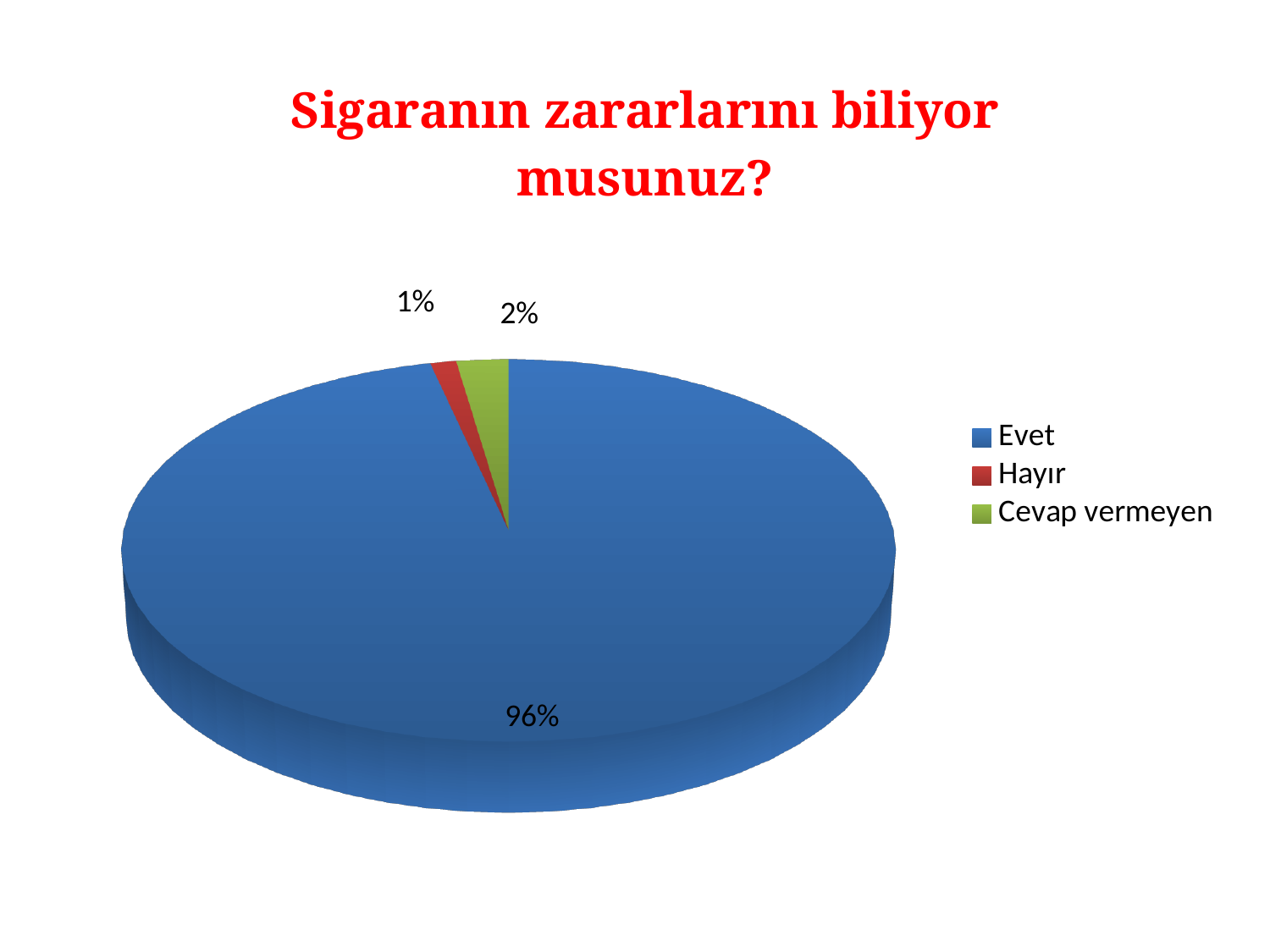
What is the difference between the values for Cevap vermeyen and Hayır? 1% What kind of chart is shown on the slide? pie chart What colour represents Evet in the chart? blue What is the value for Hayır? 1% What is the title of the chart? Sigaranın zararlarını biliyor musunuz? Which is larger, the value for Cevap vermeyen or the value for Hayır? Cevap vermeyen Which category has the largest share of the pie? Evet How many categories does the pie chart have? 3 What is the value for Cevap vermeyen? 2% Which category has the smallest share of the pie? Hayır What is the difference between the values for Evet and Cevap vermeyen? 94% What is the value for Evet? 96%